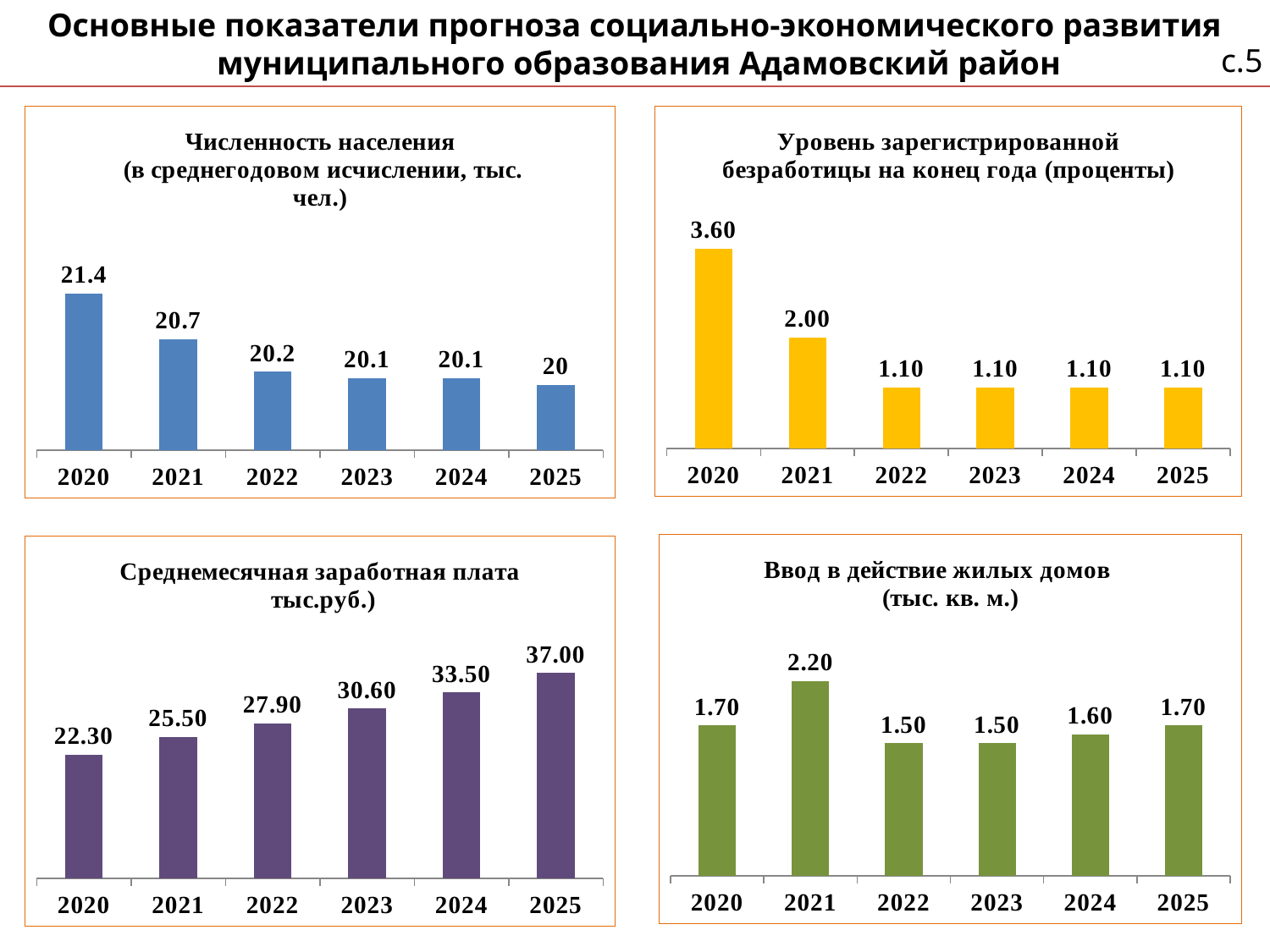
In the 'Численность населения' chart (top left), do the values rise or fall from 2020 to 2025? fall In the 'Уровень зарегистрированной безработицы' chart (top right), what is the difference between the 2020 and 2021 values? 1.60 What type of chart is the 'Ввод в действие жилых домов' chart (bottom right)? bar chart In the 'Среднемесячная заработная плата' chart (bottom left), what is the difference between the 2023 and 2022 values? 2.70 In the 'Уровень зарегистрированной безработицы' chart (top right), how many years are shown? 6 In the 'Численность населения' chart (top left), which year has the lowest value? 2025 In the 'Ввод в действие жилых домов' chart (bottom right), which year has the highest value? 2021 In the 'Ввод в действие жилых домов' chart (bottom right), which is larger, the value for 2020 or the value for 2024? 2020 In the 'Среднемесячная заработная плата' chart (bottom left), what is the value for 2025? 37.00 In the 'Численность населения' chart (top left), what is the value for 2020? 21.4 In the 'Уровень зарегистрированной безработицы' chart (top right), what is the value for 2021? 2.00 In the 'Среднемесячная заработная плата' chart (bottom left), do the values rise or fall from 2020 to 2025? rise